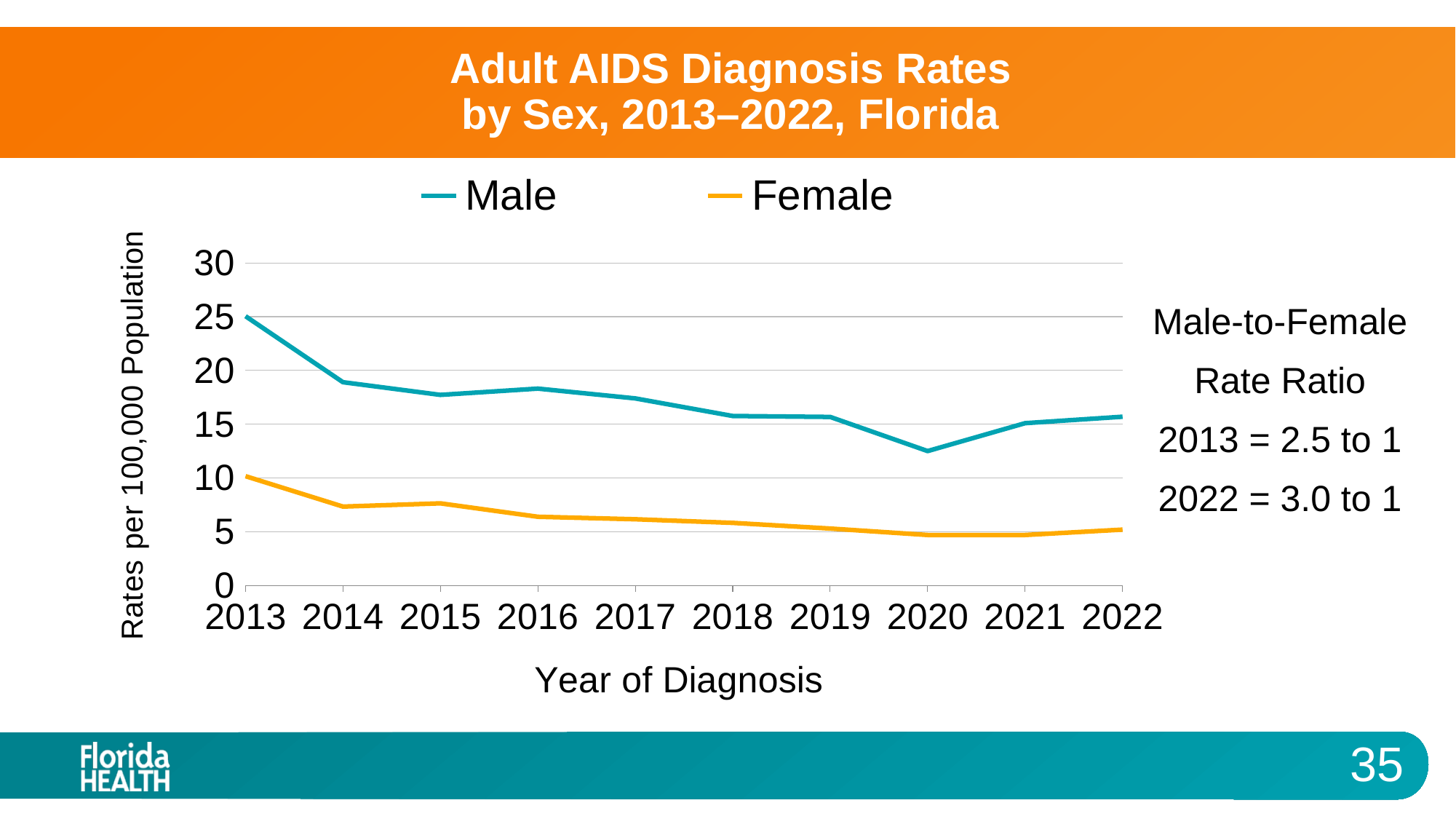
How many years are plotted along the x axis? 10 How many series does the legend list? 2 What kind of chart is shown on the slide? line chart What is the Male-to-Female rate ratio stated for 2022? 3.0 to 1 Is the Male rate in 2020 greater or less than 15? less Is the Female rate in 2016 greater or less than 10? less In which year is the Male rate highest? 2013 Which series has the higher rate in 2018, Male or Female? Male In which year is the Male rate lowest? 2020 Is the Male rate in 2014 greater or less than 20? less In which year is the Female rate highest? 2013 Does the Male rate rise or fall from 2013 to 2020? fall